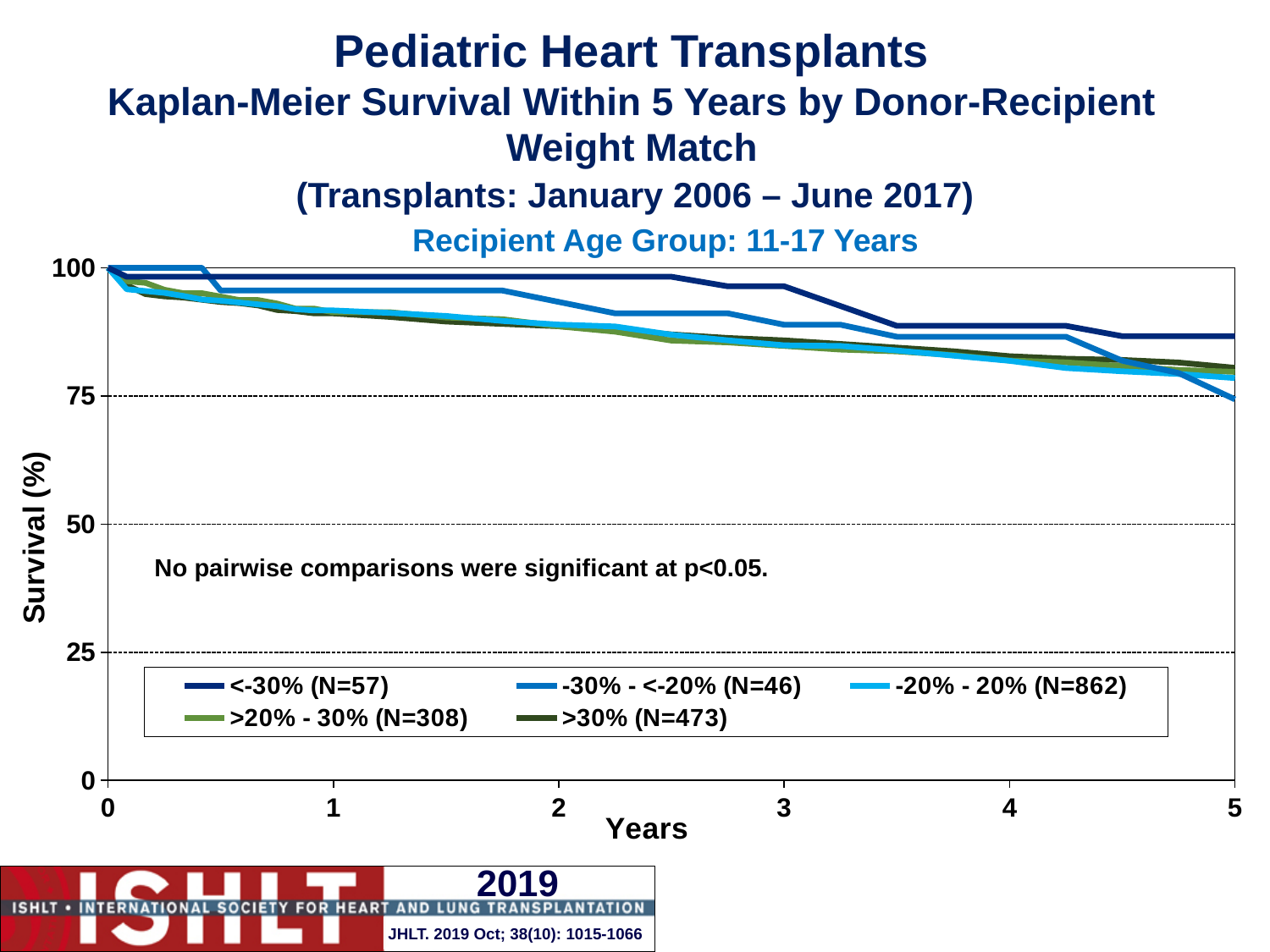
At 5 years, which group has the highest survival? <-30% (N=57) At 5 years, which group has the lowest survival? -30% - <-20% (N=46) Do the survival curves rise or fall as years increase? Fall At 5 years, is the survival for the -30% - <-20% group greater or less than 50? greater How many series does the legend list? 5 What is the label of the y axis? Survival (%) What kind of chart is shown on the slide? Line chart At 5 years, is the survival for the <-30% group greater or less than 75? greater At 3 years, is the survival for the <-30% group greater or less than 75? greater At 3 years, which has higher survival: the <-30% group or the >30% group? <-30% group Which donor-recipient weight match group has N=862? -20% - 20% At 5 years, which has higher survival: the <-30% group or the -30% - <-20% group? <-30% group